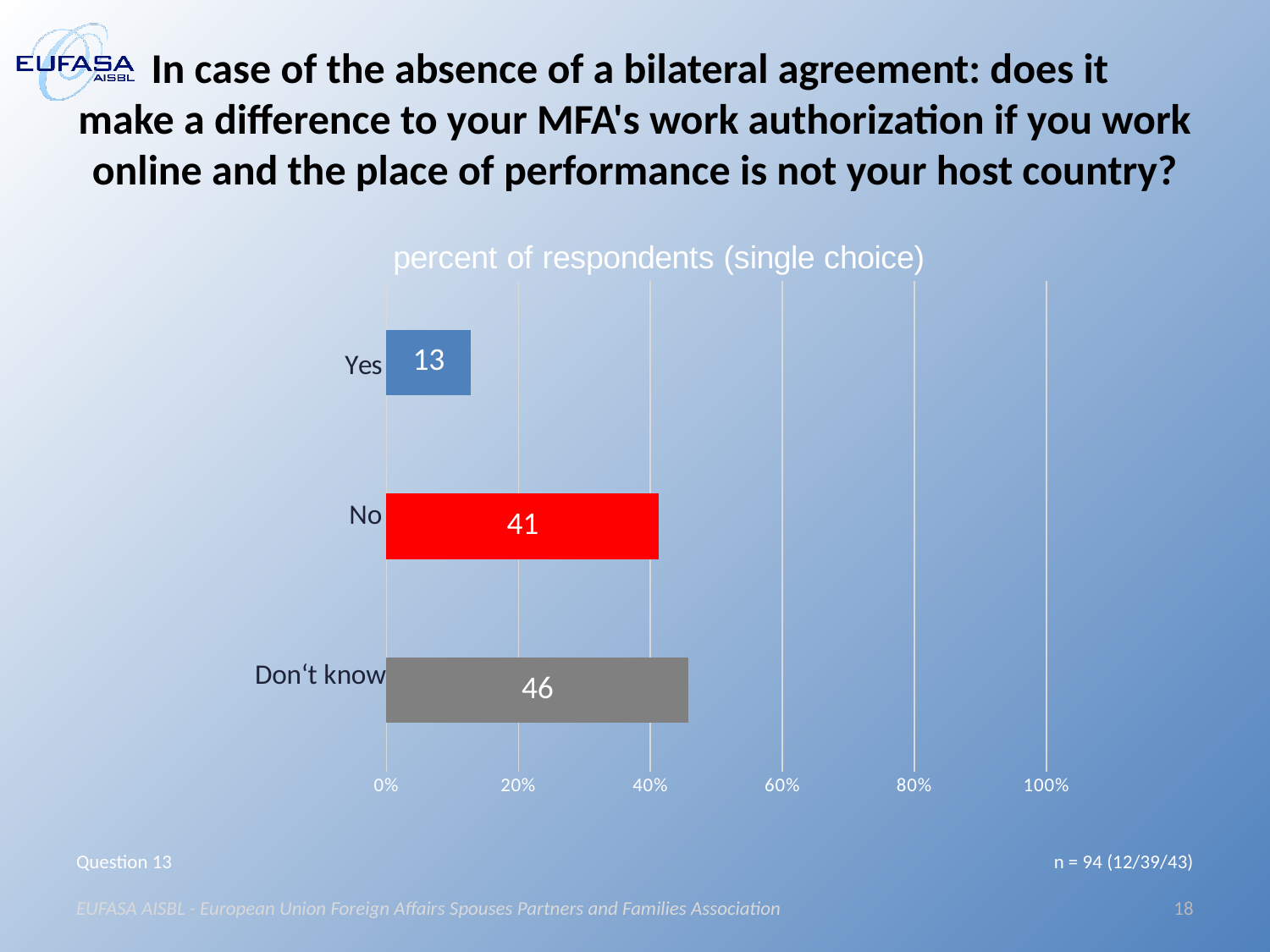
Which is larger, the value for "No" or the value for "Yes"? No What is the value for "Don't know"? 46 How many categories are shown in the chart? 3 What is the value for "Yes"? 13 What is the title of the chart? percent of respondents (single choice) What is the difference between the values for "Don't know" and "No"? 5 Which category has the highest value? Don't know Which category has the lowest value? Yes Is the value for "Don't know" greater or less than 40%? greater What is the value for "No"? 41 What kind of chart is shown on the slide? bar chart What is the difference between the values for "No" and "Yes"? 28